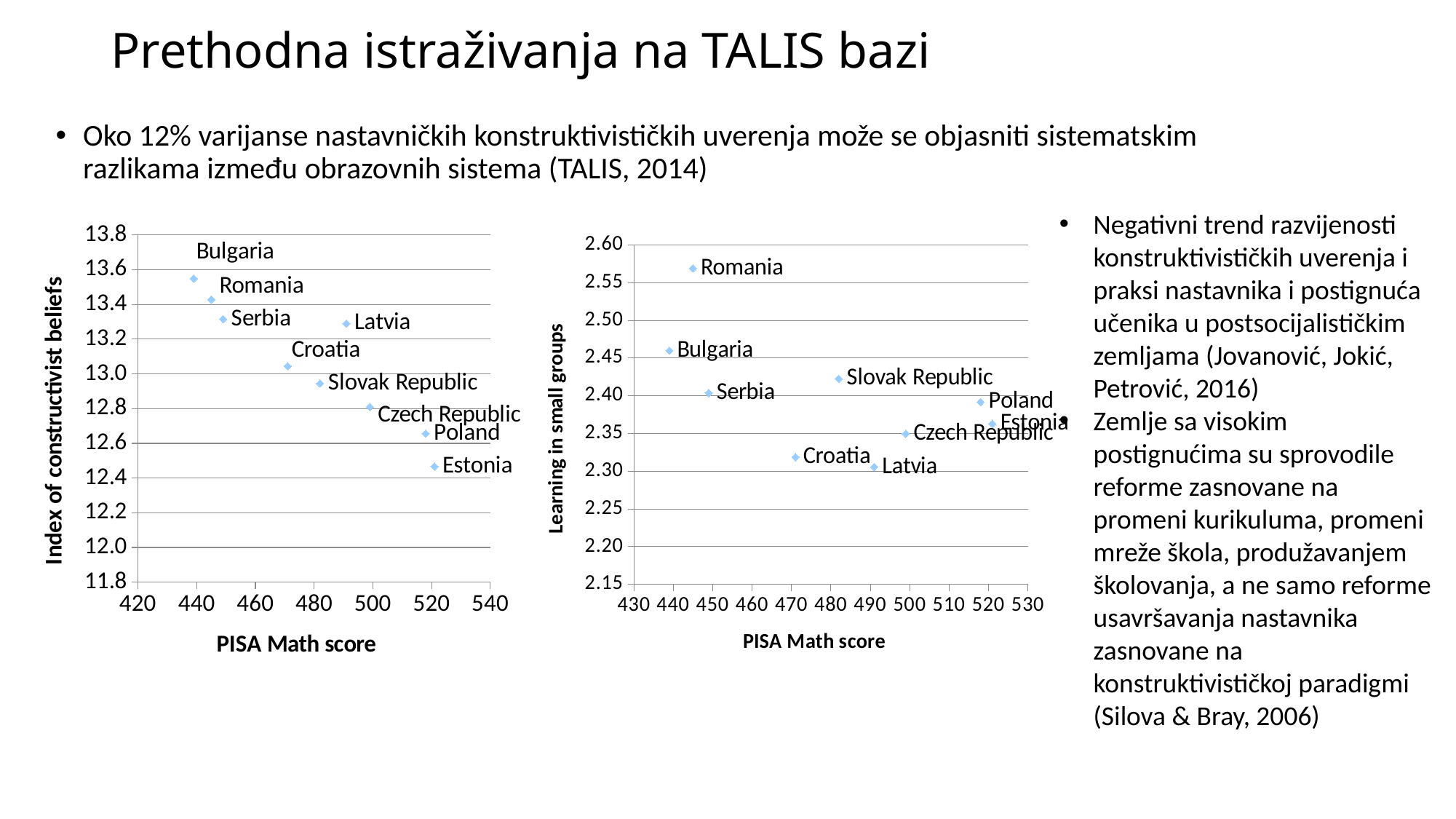
What is the x-axis title of the right chart (Learning in small groups)? PISA Math score In the right chart (Learning in small groups), which has a higher value, Bulgaria or Croatia? Bulgaria In the right chart (Learning in small groups), is the value for Romania greater or less than 2.55? greater In the left chart (Index of constructivist beliefs), does the index of constructivist beliefs generally rise or fall as PISA Math score increases? fall In the left chart (Index of constructivist beliefs), which country has the highest index of constructivist beliefs? Bulgaria In the left chart (Index of constructivist beliefs), is the value for Bulgaria greater or less than 13.4? greater In the right chart (Learning in small groups), which country has the highest value for learning in small groups? Romania In the left chart (Index of constructivist beliefs), how many countries are plotted? 9 What kind of chart is the left chart (Index of constructivist beliefs)? scatter chart In the left chart (Index of constructivist beliefs), is the value for Estonia greater or less than 12.6? less In the left chart (Index of constructivist beliefs), which country has the lowest index of constructivist beliefs? Estonia In the left chart (Index of constructivist beliefs), which has a higher index of constructivist beliefs, Romania or Poland? Romania